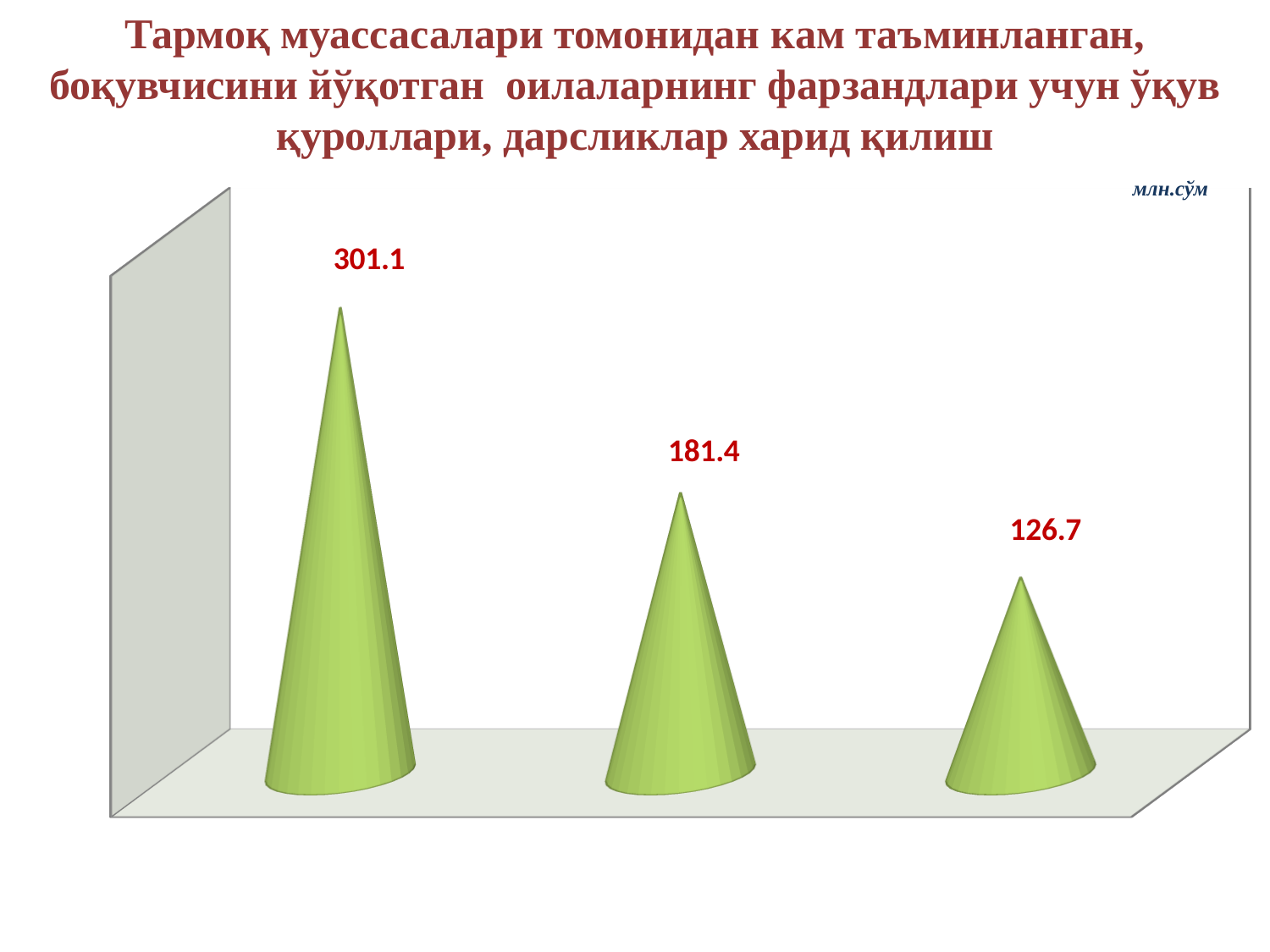
How many bars are plotted on the chart? 3 What is the difference between the leftmost bar's value and the middle bar's value? 119.7 What is the difference between the middle bar's value and the rightmost bar's value? 54.7 What kind of chart is shown on the slide? bar chart Which bar has the lowest value: the leftmost, middle or rightmost? rightmost Which bar has the highest value: the leftmost, middle or rightmost? leftmost What value is shown for the middle bar? 181.4 What unit is indicated in the top right corner of the chart? млн.сўм What value is shown for the rightmost bar? 126.7 Which is larger, the value of the middle bar or the value of the rightmost bar? the middle bar Do the values rise or fall from left to right across the chart? fall What value is shown for the leftmost bar? 301.1